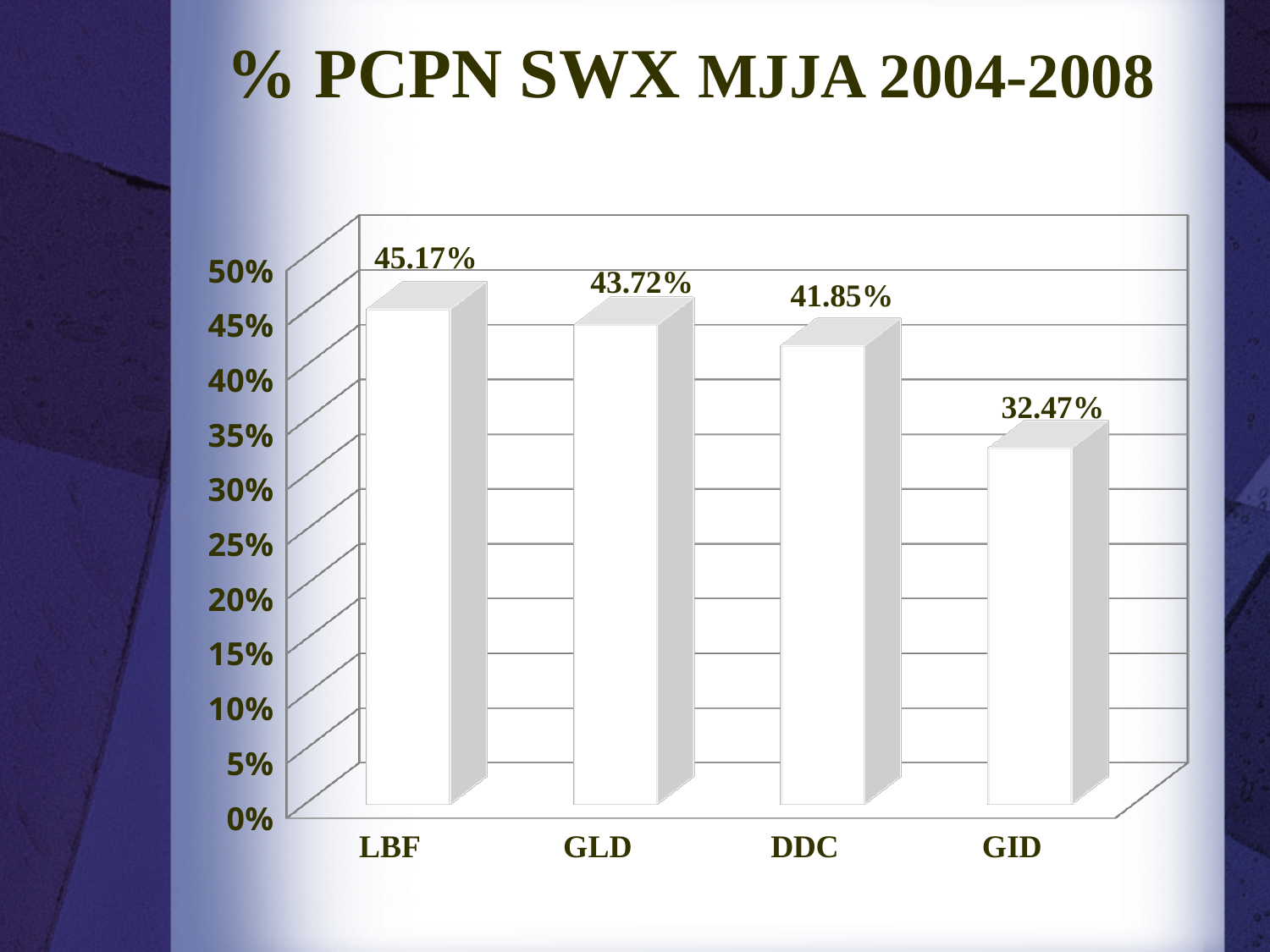
What is the value for LBF? 45.17% What is the difference between the values for LBF and GID? 12.70% How many categories are shown on the x axis? 4 What kind of chart is shown on the slide? bar chart Which category has the lowest value? GID Which is larger, the value for DDC or the value for GID? DDC What is the value for GLD? 43.72% What is the value for GID? 32.47% What is the title of the chart? % PCPN SWX MJJA 2004-2008 Which category has the highest value? LBF What is the difference between the values for GLD and DDC? 1.87% What is the value for DDC? 41.85%